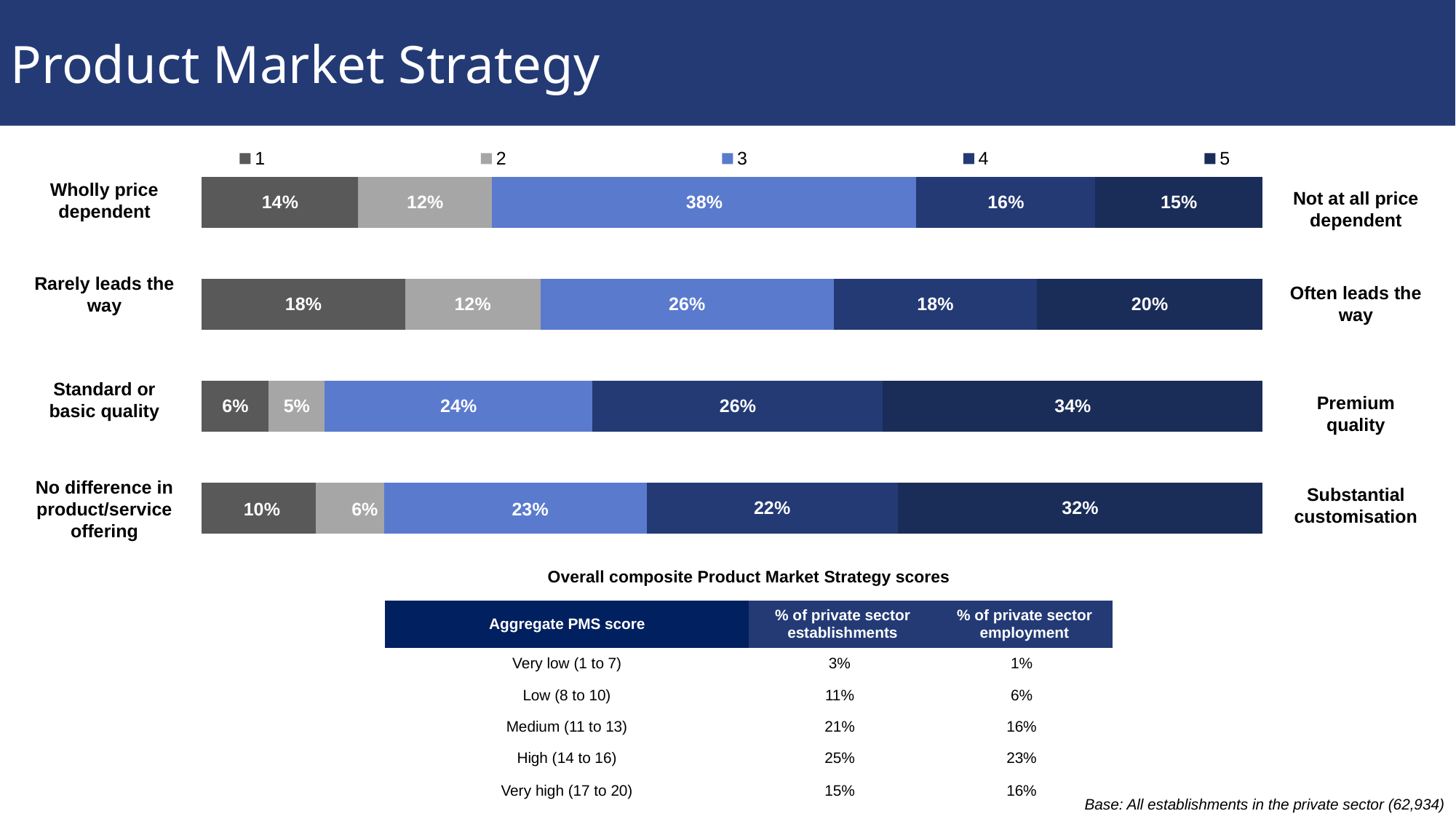
What is the value for series 2 in the 'No difference in product/service offering' to 'Substantial customisation' bar? 6% What is the total of the segments in the 'Standard or basic quality' to 'Premium quality' bar? 95% What kind of chart is shown on the slide? Stacked bar chart What is the value for series 3 in the 'Wholly price dependent' to 'Not at all price dependent' bar? 38% How many series does the chart legend list? 5 How many bars (rows) does the chart have? 4 What is the difference between the series 5 and series 1 values in the 'No difference in product/service offering' to 'Substantial customisation' bar? 22% What is the value for series 5 in the 'Standard or basic quality' to 'Premium quality' bar? 34% Which series has the smallest segment in the 'Standard or basic quality' to 'Premium quality' bar? 2 Which series has the largest segment in the 'Wholly price dependent' to 'Not at all price dependent' bar? 3 In the 'Rarely leads the way' to 'Often leads the way' bar, which is larger: series 3 or series 5? Series 3 What is the value for series 1 in the 'Rarely leads the way' to 'Often leads the way' bar? 18%